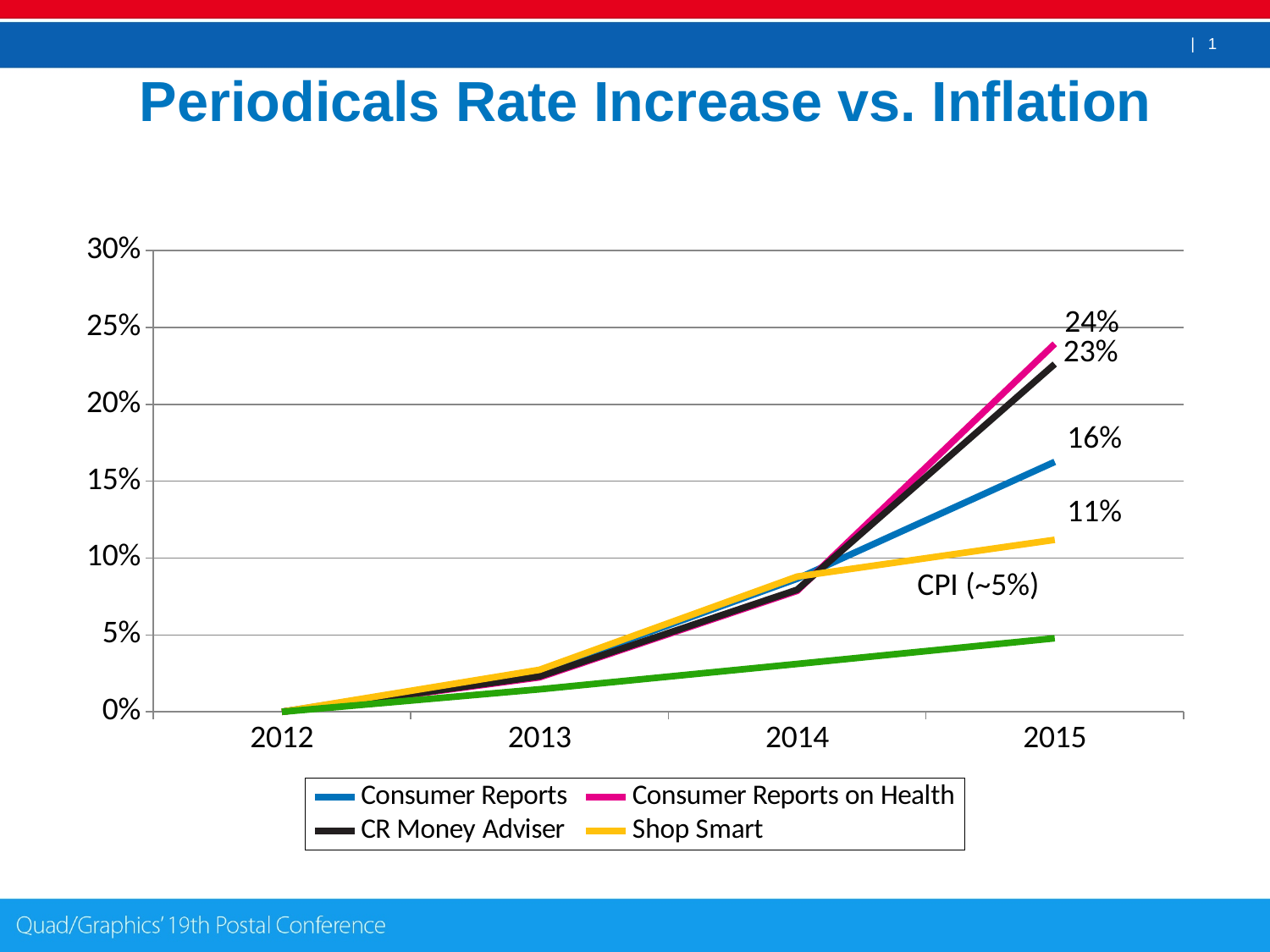
What kind of chart is shown on the slide? line chart Does the Consumer Reports on Health line rise or fall from 2012 to 2015? rises Which of the four legend series has the lowest value in 2015? Shop Smart What is the difference between the 2015 values for Consumer Reports on Health and Shop Smart? 13 percentage points What is the value for Consumer Reports on Health in 2015? 24% What is the value for CR Money Adviser in 2015? 23% In 2015, which is larger: the value for Consumer Reports or the value for Shop Smart? Consumer Reports Is the value for Consumer Reports in 2013 greater or less than 5%? less What is the value for Shop Smart in 2015? 11% What is the value for Consumer Reports in 2015? 16% How many series does the legend list? 4 Which legend series has the highest value in 2015? Consumer Reports on Health